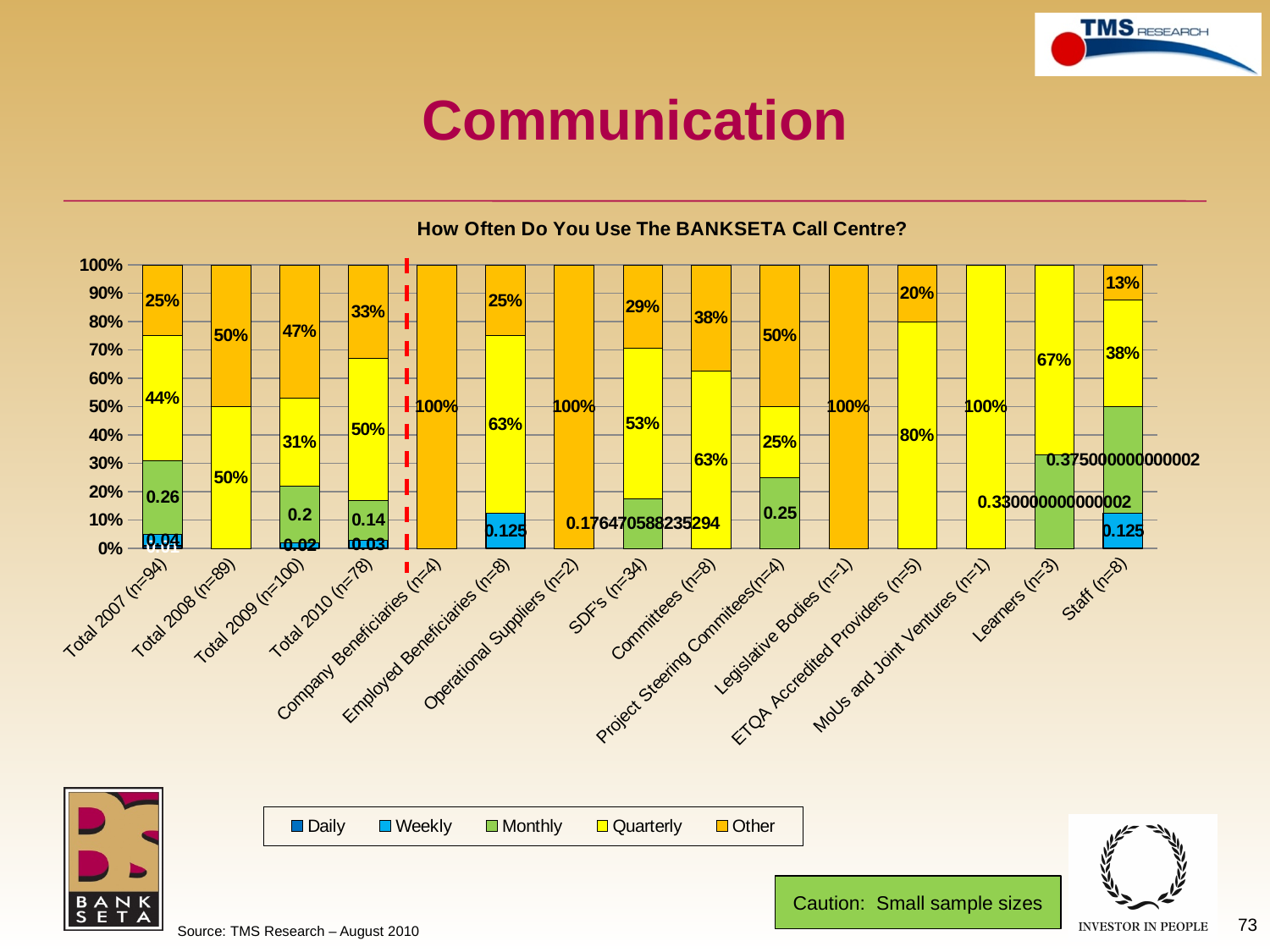
What is the Quarterly value for Learners (n=3)? 67% How many series does the legend list? 5 What is the Monthly value for Project Steering Committees (n=4)? 0.25 Which has the larger Quarterly value, Employed Beneficiaries (n=8) or Total 2009 (n=100)? Employed Beneficiaries (n=8) What is the Other value for Staff (n=8)? 13% What is the Quarterly value for ETQA Accredited Providers (n=5)? 80% What is the title of the chart? How Often Do You Use The BANKSETA Call Centre? What kind of chart is shown on the slide? Stacked bar chart What is the difference between the Other value for Total 2008 (n=89) and the Other value for Total 2007 (n=94)? 25% What is the Other value for Committees (n=8)? 38% How many categories are shown along the x axis? 15 What is the Other value for Total 2007 (n=94)? 25%